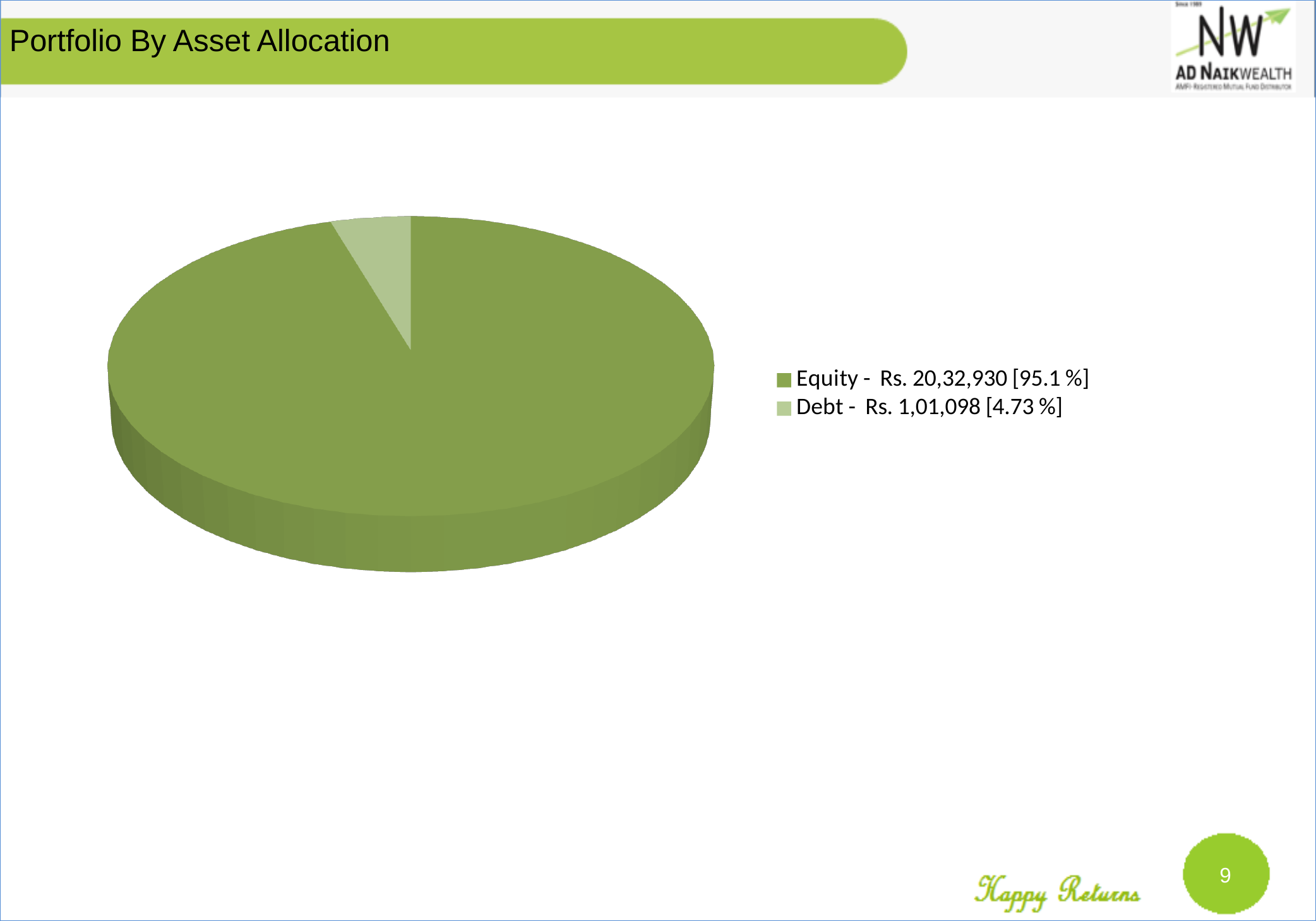
What is the title of the slide containing the chart? Portfolio By Asset Allocation Which category has the smallest slice? Debt What is the value for Equity? Rs. 20,32,930 What kind of chart is shown on the slide? pie chart What is the value for Debt? Rs. 1,01,098 What share of the pie does Debt represent? 4.73 % Which is larger, Equity or Debt? Equity What share of the pie does Equity represent? 95.1 % How many categories does the pie chart show? 2 Which category has the largest slice? Equity What is the difference in rupees between Equity and Debt? Rs. 19,31,832 How many entries does the legend list? 2